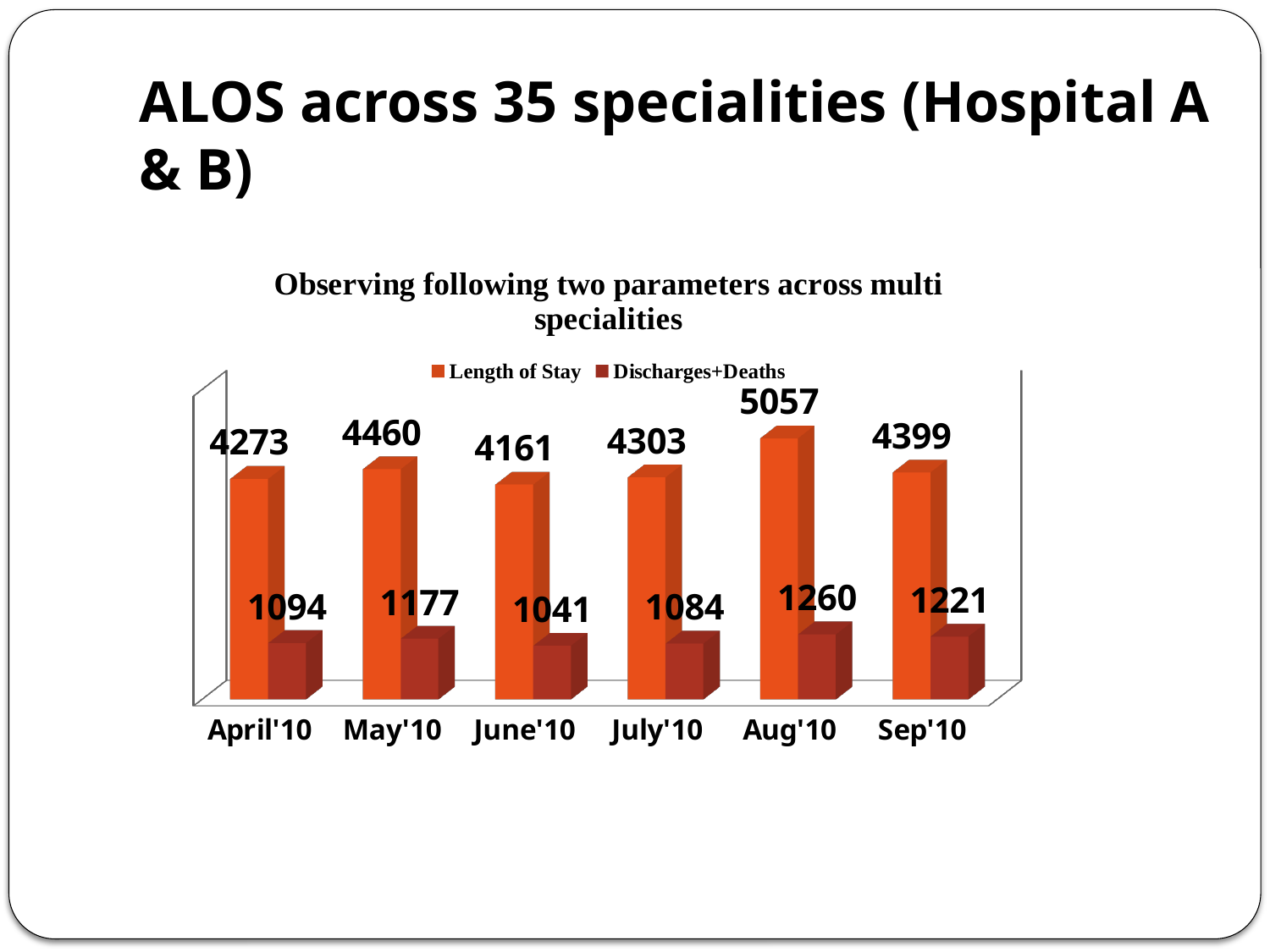
What is the title of the chart? Observing following two parameters across multi specialities What is the difference between the Length of Stay values for Aug'10 and June'10? 896 What is the Discharges+Deaths value for June'10? 1041 Which month has the lowest Discharges+Deaths value? June'10 What is the Length of Stay value for Aug'10? 5057 How many months are shown on the x axis? 6 Which is larger, the Length of Stay for May'10 or for Sep'10? May'10 What is the difference between the Discharges+Deaths values for Aug'10 and Sep'10? 39 How many series does the legend list? 2 What is the Length of Stay value for April'10? 4273 What kind of chart is shown on the slide? Bar chart Which month has the highest Length of Stay? Aug'10